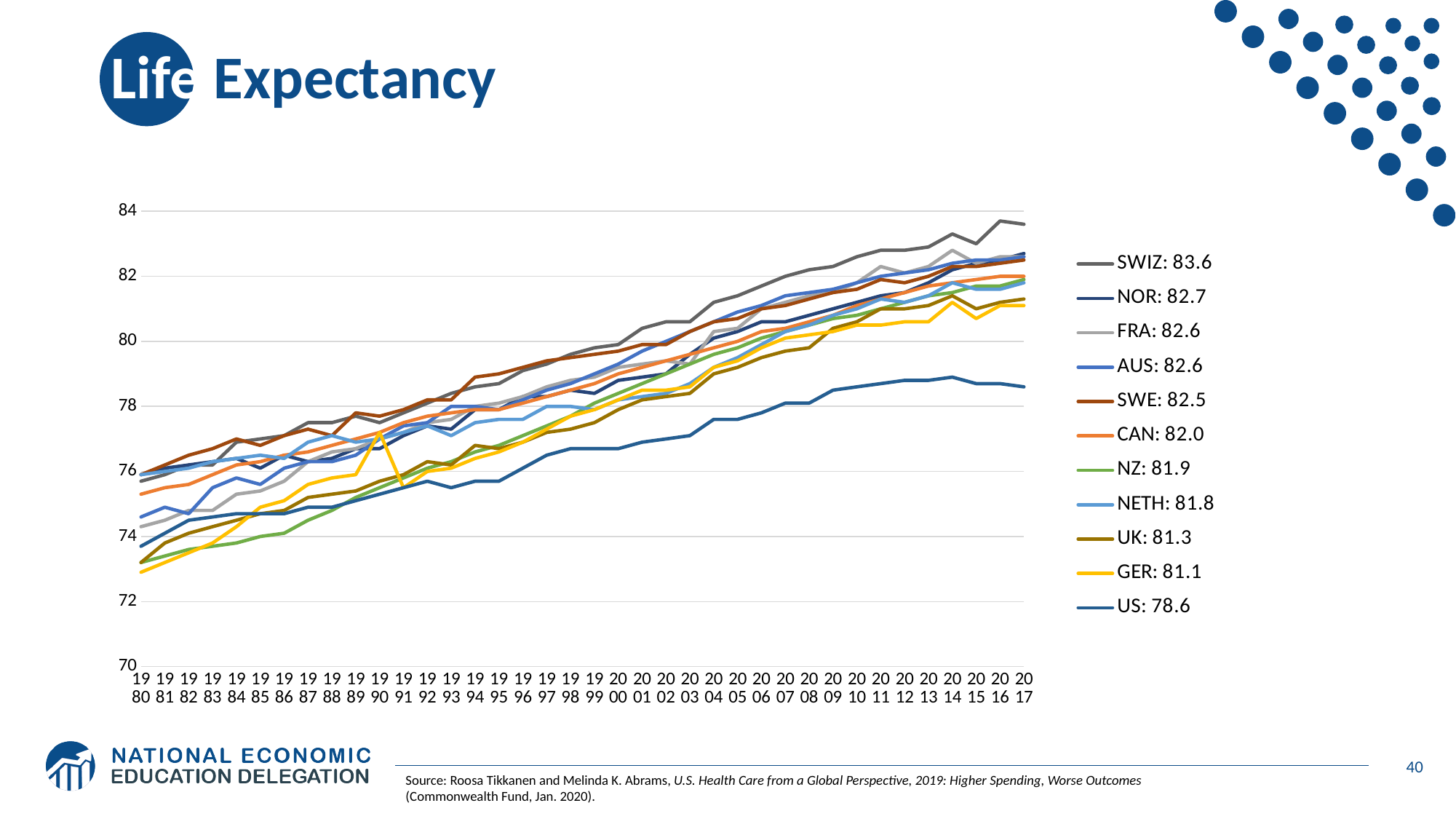
What type of chart is shown on the slide? line chart Is the value for US in 1980 greater or less than 74? less What life expectancy value is shown for UK in the legend? 81.3 What is the difference between the legend values for SWIZ and US? 5.0 What life expectancy value is shown for SWIZ in the legend? 83.6 How many series does the legend list? 11 What life expectancy value is shown for US in the legend? 78.6 Which has a higher legend value, NOR or SWE? NOR Which country has the highest life expectancy value in the legend? SWIZ Which country has the lowest life expectancy value in the legend? US How many years are shown along the x axis? 38 Does the SWIZ line generally rise or fall from 1980 to 2017? rise